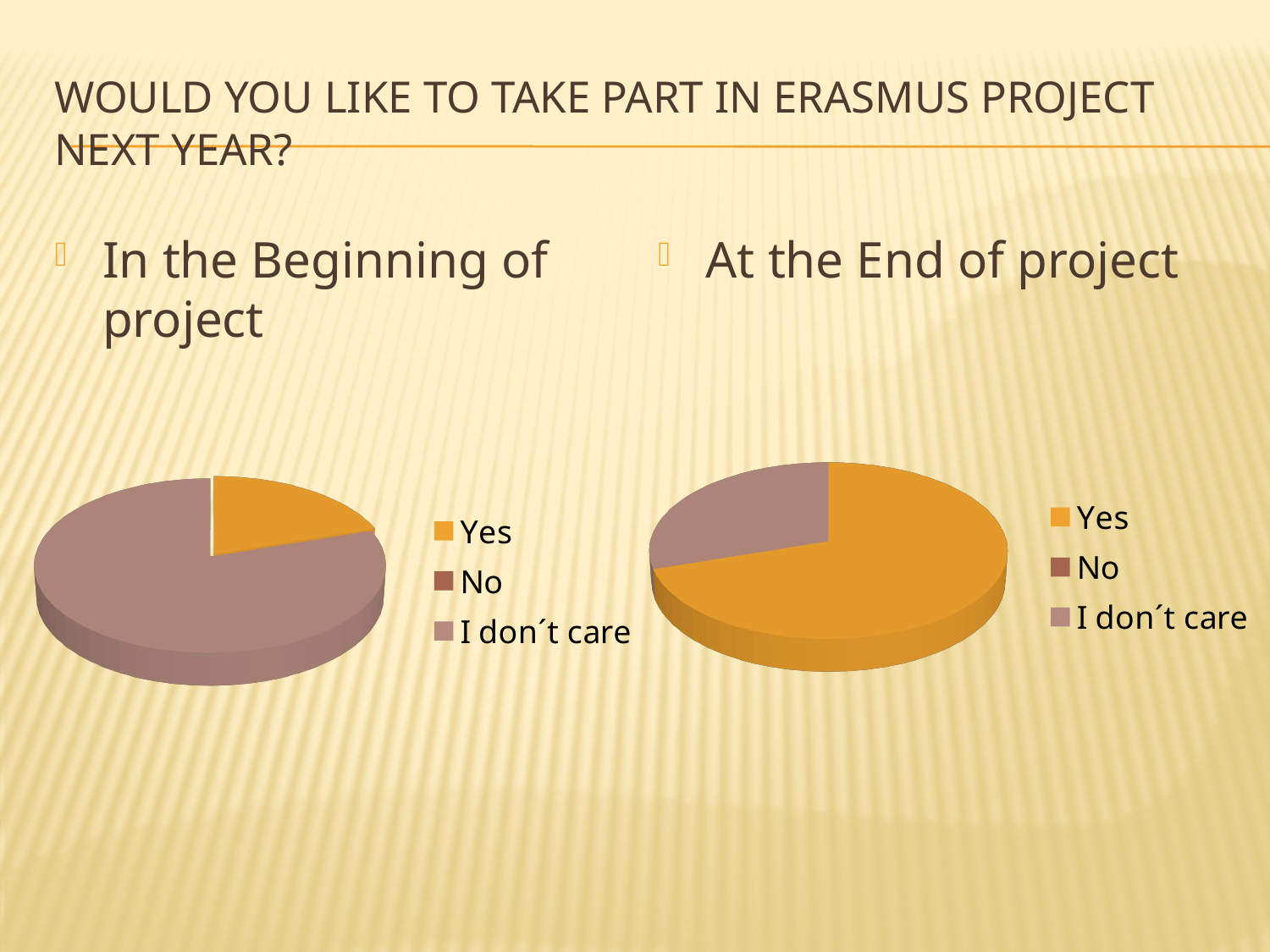
In the "In the Beginning of project" pie chart, which category has the largest slice? I don´t care In the "At the End of project" pie chart, which category has the largest slice? Yes In the "In the Beginning of project" pie chart, which slice is larger: Yes or I don´t care? I don´t care In the "In the Beginning of project" pie chart, which category is shown in the mauve/pinkish-brown colour? I don´t care How many categories does the legend of the "At the End of project" pie chart list? 3 What kind of chart is shown on the left side of the slide, under "In the Beginning of project"? pie chart How many categories does the legend of the "In the Beginning of project" pie chart list? 3 How many pie charts are on the slide? 2 In the "At the End of project" pie chart, which slice is larger: Yes or I don´t care? Yes What kind of chart is shown on the right side of the slide, under "At the End of project"? pie chart In the "At the End of project" pie chart, which category is shown in orange? Yes